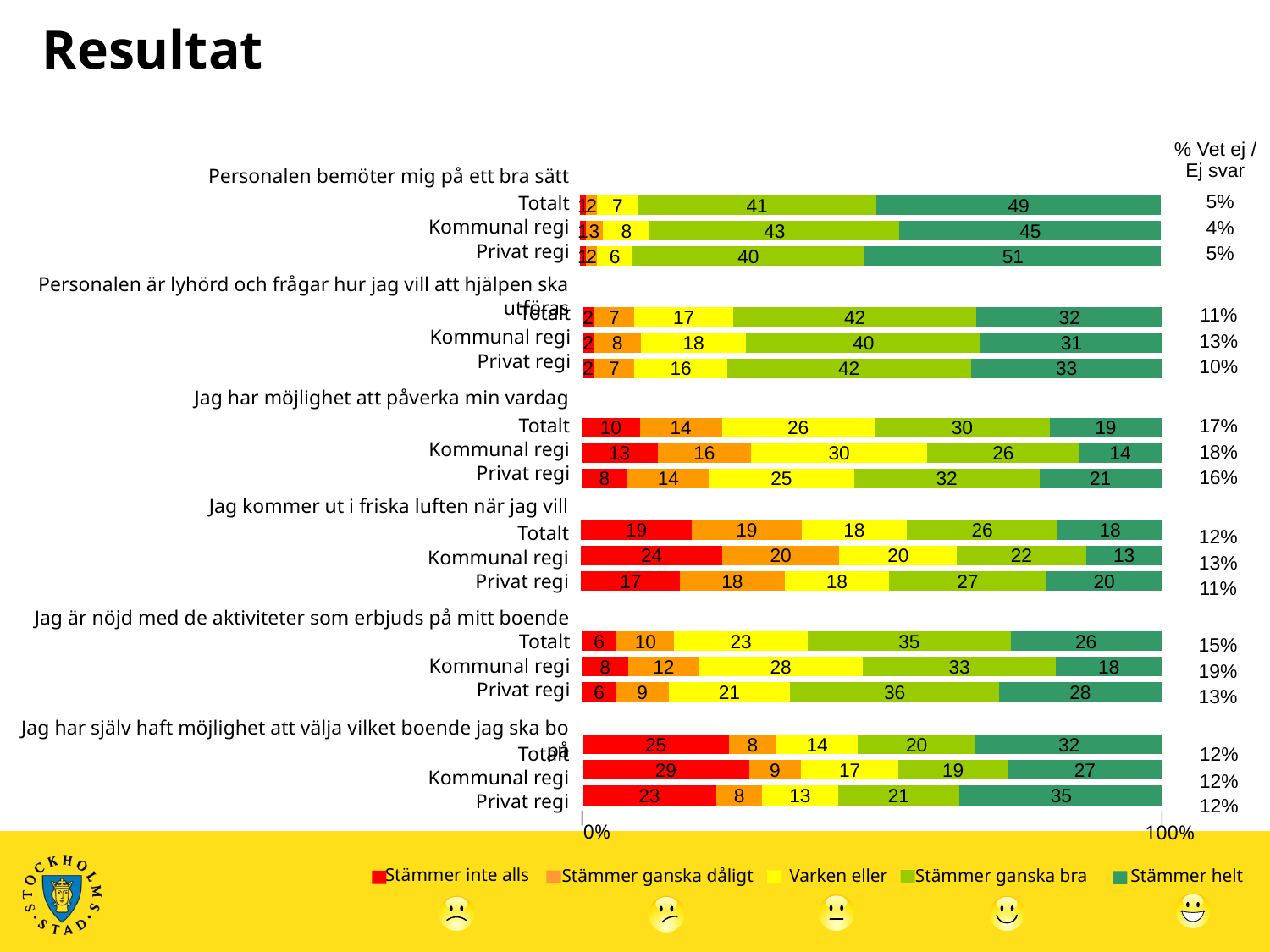
For 'Personalen bemöter mig på ett bra sätt', what is the 'Stämmer helt' value for Totalt? 49 For 'Personalen bemöter mig på ett bra sätt', what is the difference between the 'Stämmer helt' values for Privat regi and Kommunal regi? 6 How many series does the legend list? 5 What is the '% Vet ej / Ej svar' value shown for Totalt under 'Jag har möjlighet att påverka min vardag'? 17% Among the Totalt rows, which statement has the lowest 'Stämmer helt' value? Jag kommer ut i friska luften när jag vill Among the Totalt rows, which statement has the highest 'Stämmer helt' value? Personalen bemöter mig på ett bra sätt For 'Jag har möjlighet att påverka min vardag', what is the 'Stämmer ganska bra' value for Kommunal regi? 26 For 'Jag kommer ut i friska luften när jag vill', what is the 'Varken eller' value for Privat regi? 18 What kind of chart is shown on the slide? bar chart How many bars are plotted in the chart in total? 18 For 'Jag har själv haft möjlighet att välja vilket boende jag ska bo på', what is the 'Stämmer inte alls' value for Kommunal regi? 29 For 'Jag kommer ut i friska luften när jag vill', which has the larger 'Stämmer inte alls' value, Kommunal regi or Privat regi? Kommunal regi